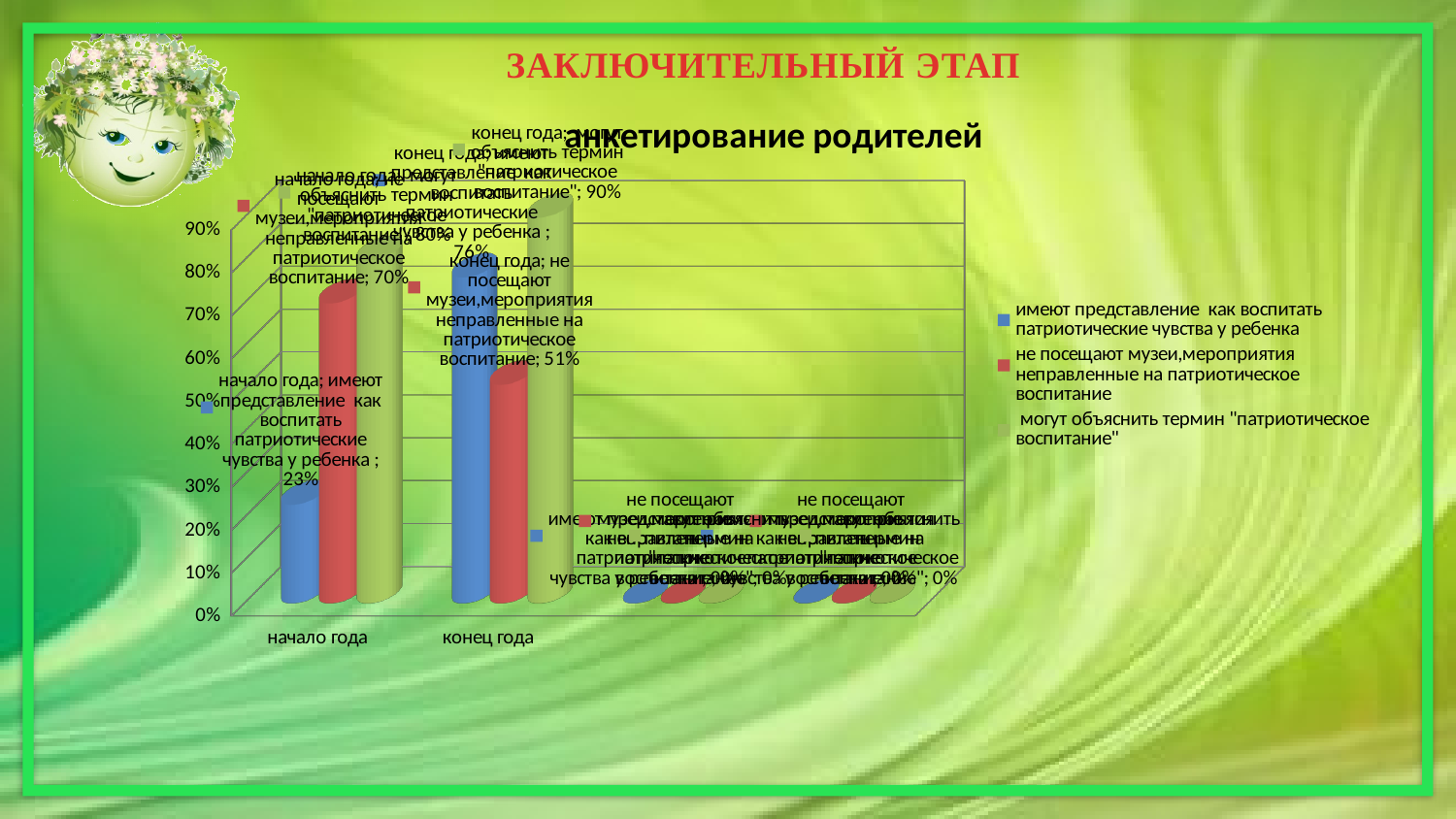
By how much did the value for 'имеют представление как воспитать патриотические чувства у ребенка' change from 'начало года' to 'конец года'? 53% What is the value for 'имеют представление как воспитать патриотические чувства у ребенка' at 'начало года'? 23% What is the title of the chart? анкетирование родителей Does the value for 'не посещают музеи, мероприятия неправленные на патриотическое воспитание' rise or fall from 'начало года' to 'конец года'? fall How many series does the legend list? 3 What is the value for 'имеют представление как воспитать патриотические чувства у ребенка' at 'конец года'? 76% What is the value for 'не посещают музеи, мероприятия неправленные на патриотическое воспитание' at 'начало года'? 70% What is the value for 'не посещают музеи, мероприятия неправленные на патриотическое воспитание' at 'конец года'? 51% Which is larger at 'конец года': 'имеют представление как воспитать патриотические чувства у ребенка' or 'не посещают музеи, мероприятия неправленные на патриотическое воспитание'? имеют представление как воспитать патриотические чувства у ребенка How many categories are shown on the x axis? 2 What type of chart is shown on the slide? bar chart What is the value for 'могут объяснить термин "патриотическое воспитание"' at 'конец года'? 90%